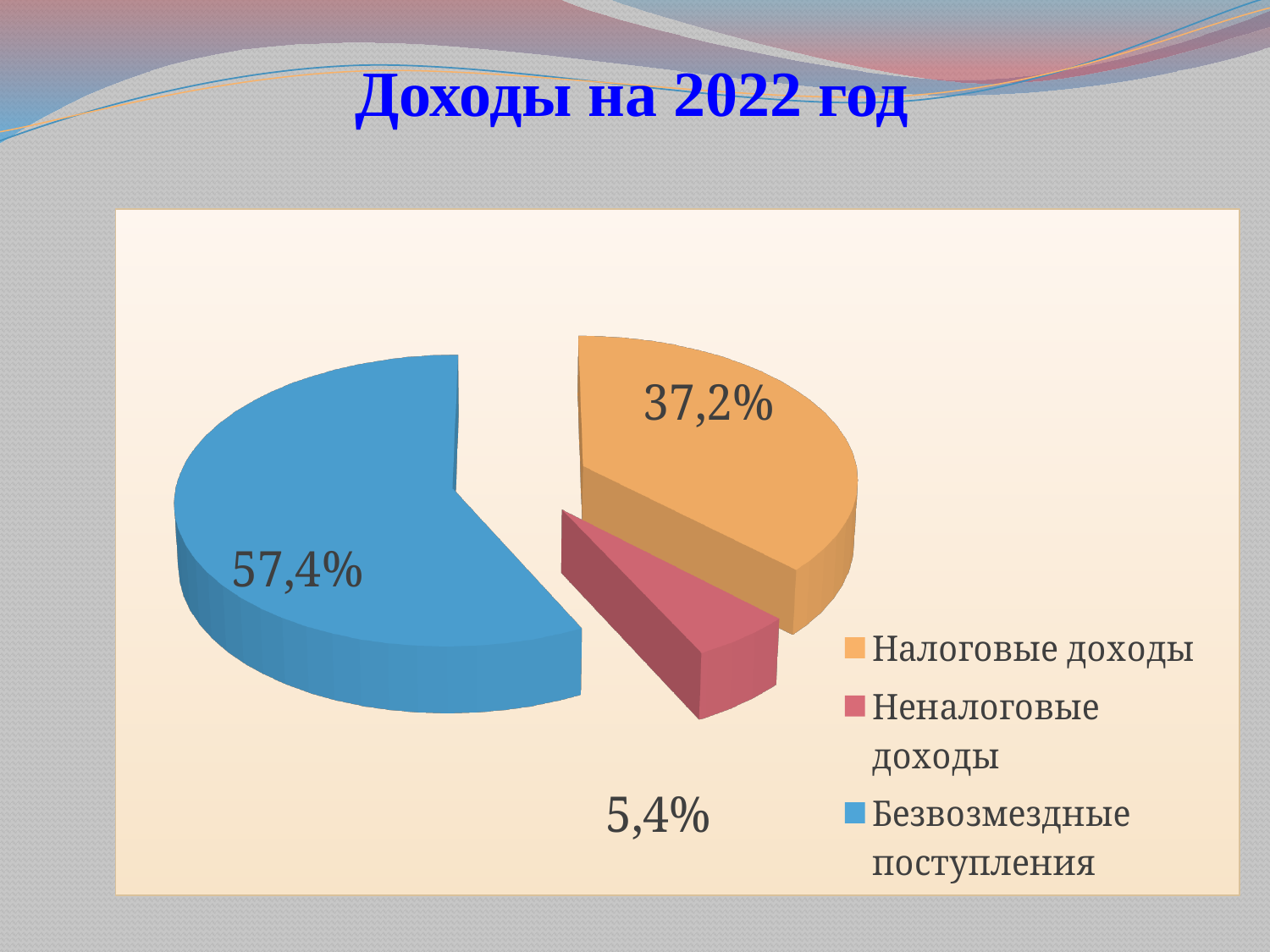
What is the difference in percentage points between Налоговые доходы and Неналоговые доходы? 31,8 What colour is the slice for Безвозмездные поступления? Blue What share of the pie does Безвозмездные поступления have? 57,4% What kind of chart is shown on the slide? Pie chart How many slices does the pie chart have? 3 What is the difference in percentage points between Безвозмездные поступления and Налоговые доходы? 20,2 Which category has the largest slice of the pie? Безвозмездные поступления What is the title of the slide? Доходы на 2022 год What share of the pie does Неналоговые доходы have? 5,4% What share of the pie does Налоговые доходы have? 37,2% Which category has the smallest slice of the pie? Неналоговые доходы Which is larger, Налоговые доходы or Неналоговые доходы? Налоговые доходы